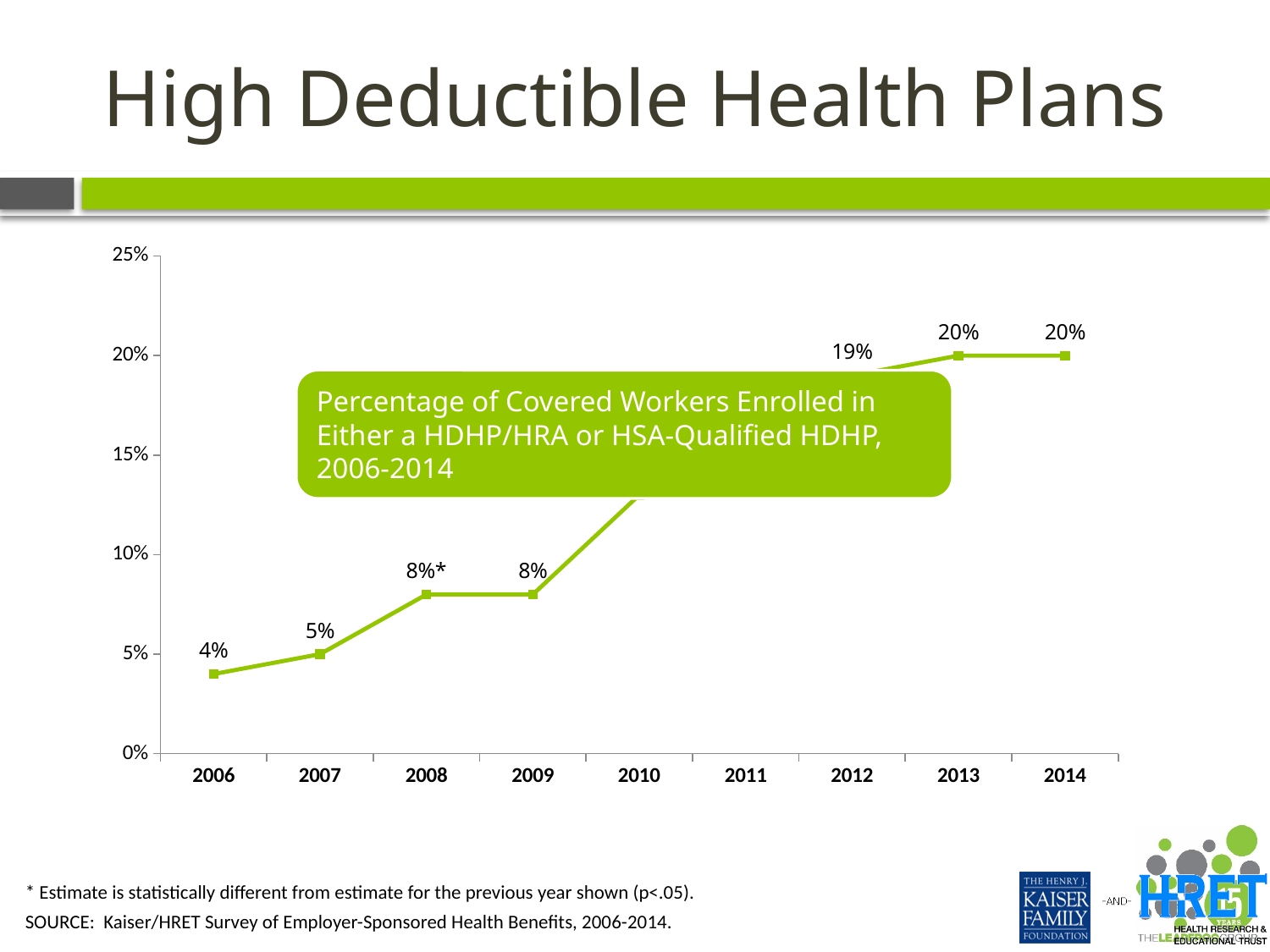
What value is shown for 2012? 19% What value is shown for 2014? 20% What value is shown for 2009? 8% Which year's data label is marked with an asterisk indicating a statistically different estimate from the previous year? 2008 What is the difference between the 2014 value and the 2006 value? 16 percentage points Which year has the lowest value on the chart? 2006 How many years are shown on the x axis? 9 Which is larger, the value for 2012 or the value for 2007? 2012 What value is shown for 2007? 5% Do the values generally rise or fall from 2006 to 2014? rise What type of chart is shown on the slide? line chart What is the percentage of covered workers enrolled in a HDHP/HRA or HSA-qualified HDHP in 2006? 4%